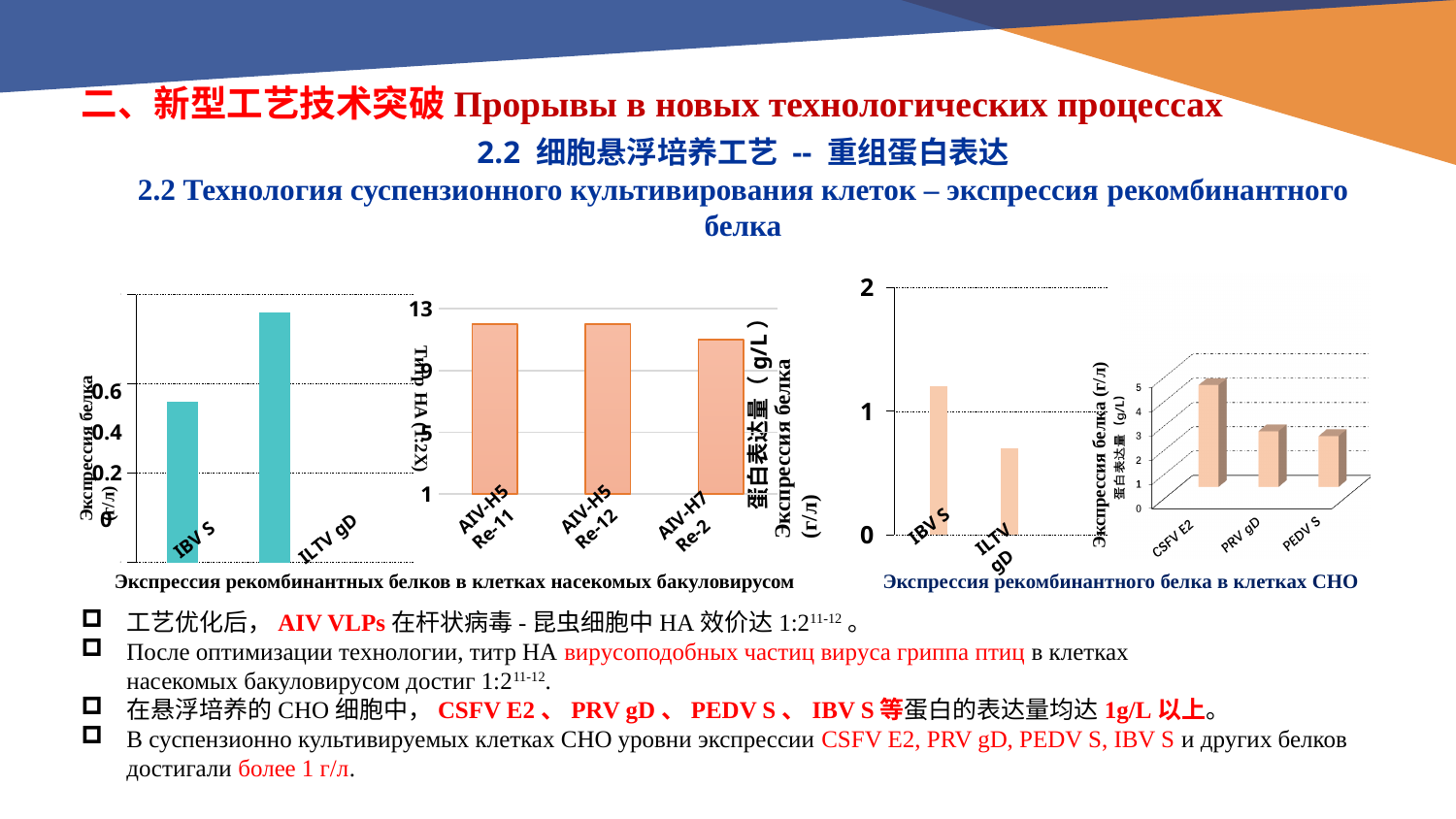
In the leftmost chart, which bar is taller, IBV S or ILTV gD? ILTV gD What kind of chart is the rightmost chart? bar chart In the leftmost chart, is the value for IBV S greater or less than 0.6? less In the second chart from the left (HA titre), how many categories are plotted? 3 In the third chart from the left (CHO cells, IBV S and ILTV gD), is the value for ILTV gD greater or less than 1? less In the rightmost chart, which category has the highest value? CSFV E2 In the third chart from the left (CHO cells, IBV S and ILTV gD), is the value for IBV S greater or less than 1? greater In the second chart from the left (HA titre), which category has the lowest value? AIV-H7 Re-2 In the leftmost chart, how many categories are plotted? 2 In the rightmost chart, how many categories are plotted? 3 In the third chart from the left (CHO cells, IBV S and ILTV gD), which category has the higher value? IBV S